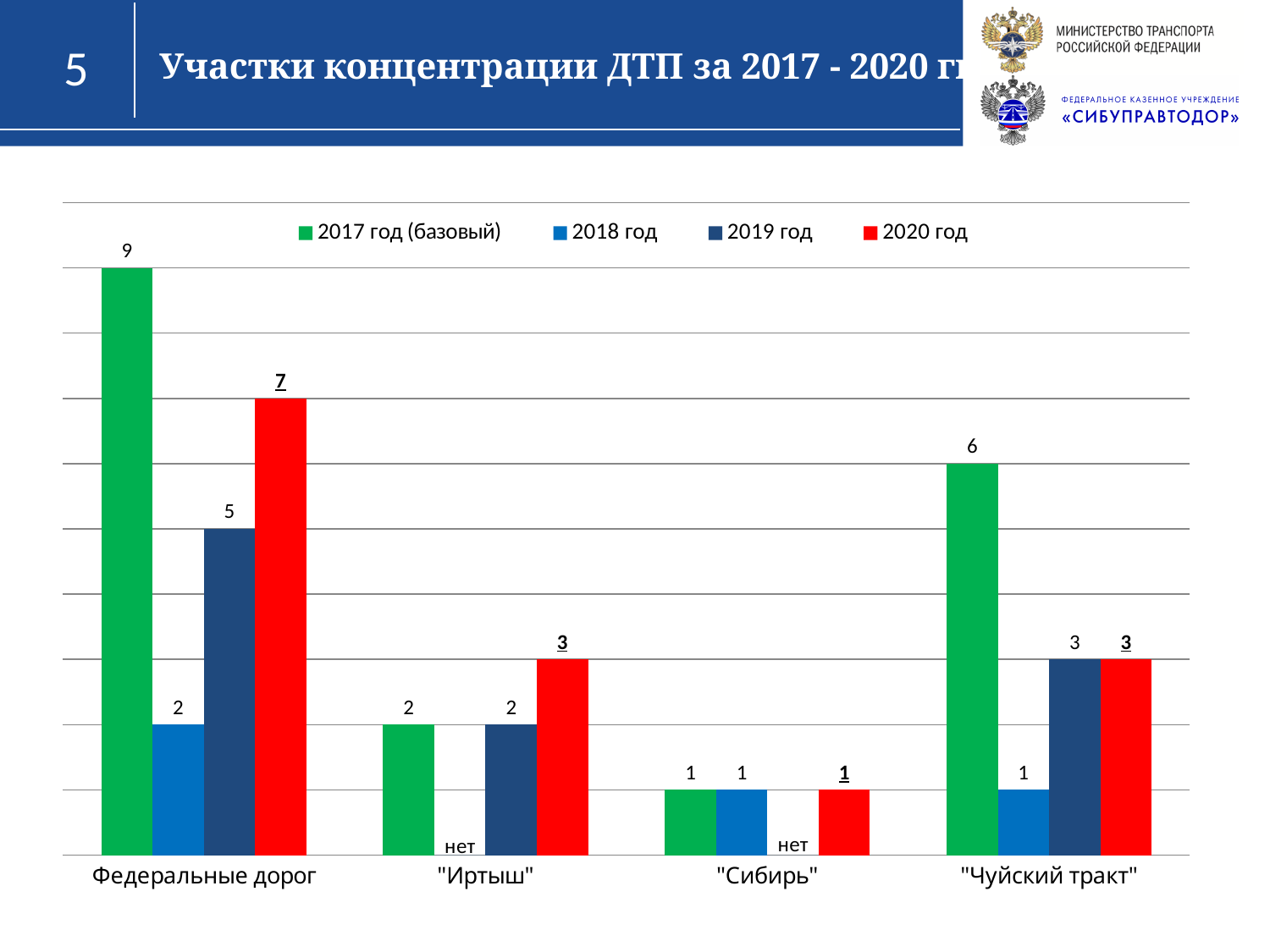
Which category has the highest value for 2017 год (базовый)? Федеральные дорог What type of chart is shown on the slide? bar chart How many series does the legend list? 4 Which category has the lowest value for 2020 год? "Сибирь" What is the value for 2019 год in the "Чуйский тракт" category? 3 What is the value for 2020 год in the "Иртыш" category? 3 What is shown for 2018 год in the "Иртыш" category? нет Which is larger in the "Чуйский тракт" category: the 2017 год (базовый) value or the 2019 год value? 2017 год (базовый) What is the difference between the 2017 год (базовый) and 2020 год values in the Федеральные дорог category? 2 How many categories are shown on the x axis? 4 What is the value for 2017 год (базовый) in the Федеральные дорог category? 9 What colour are the bars for 2020 год? red